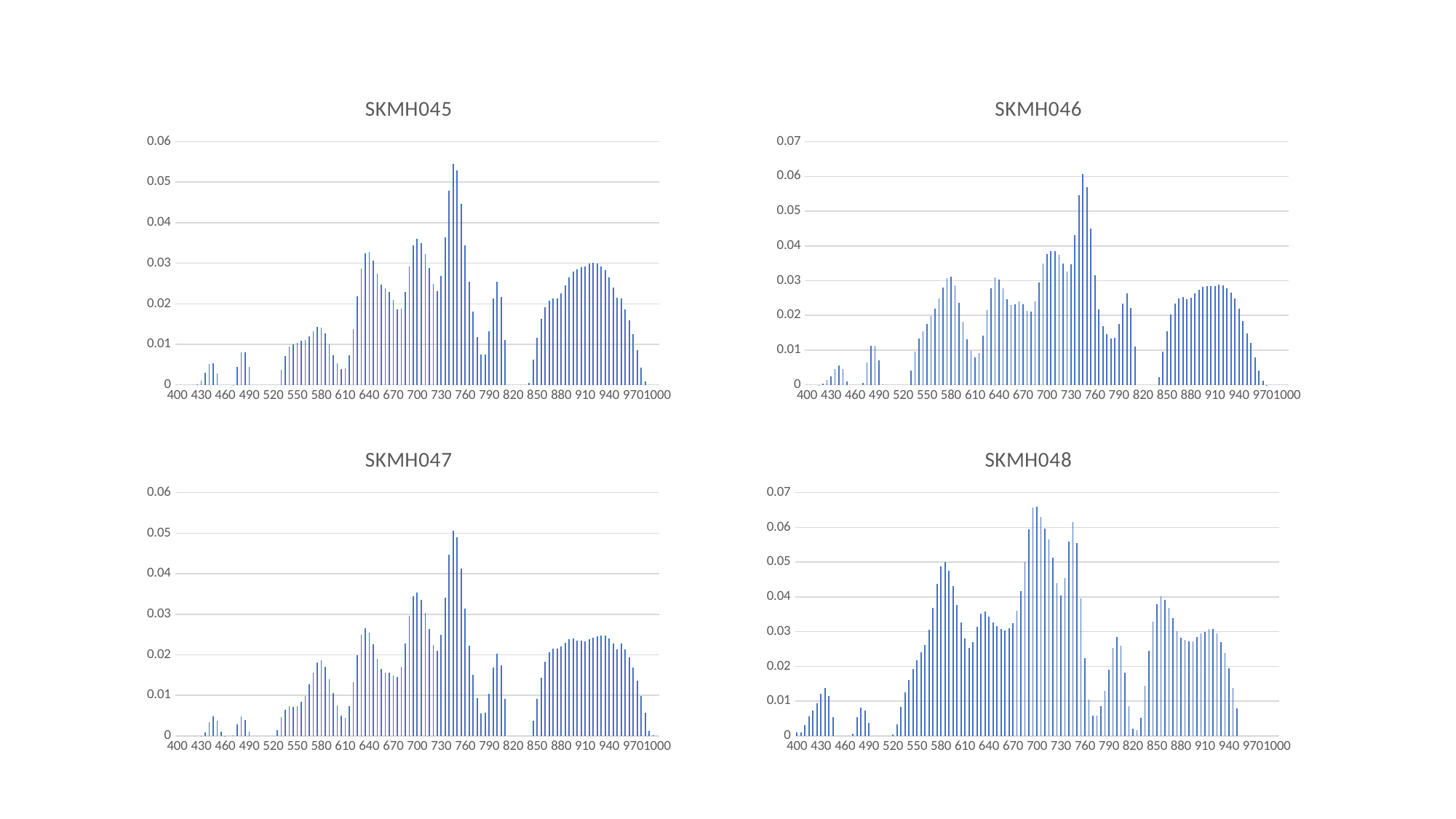
In the SKMH045 chart, is the value at 910 greater or less than 0.04? less In the SKMH045 chart, is the tallest bar (near 750) greater or less than 0.05? greater In the SKMH048 chart, do the bars rise or fall from 520 to 580 along the x axis? rise What is the top value shown on the y axis of the SKMH048 chart? 0.07 In the SKMH048 chart, is the tallest bar (near 700) greater or less than 0.06? greater What kind of chart is SKMH045? bar chart In the SKMH046 chart, which is larger: the tallest bar near 740 or the tallest bar near 580? the bar near 740 In the SKMH045 chart, do the bars rise or fall from 940 to 1000 along the x axis? fall How many charts are shown on the slide? 4